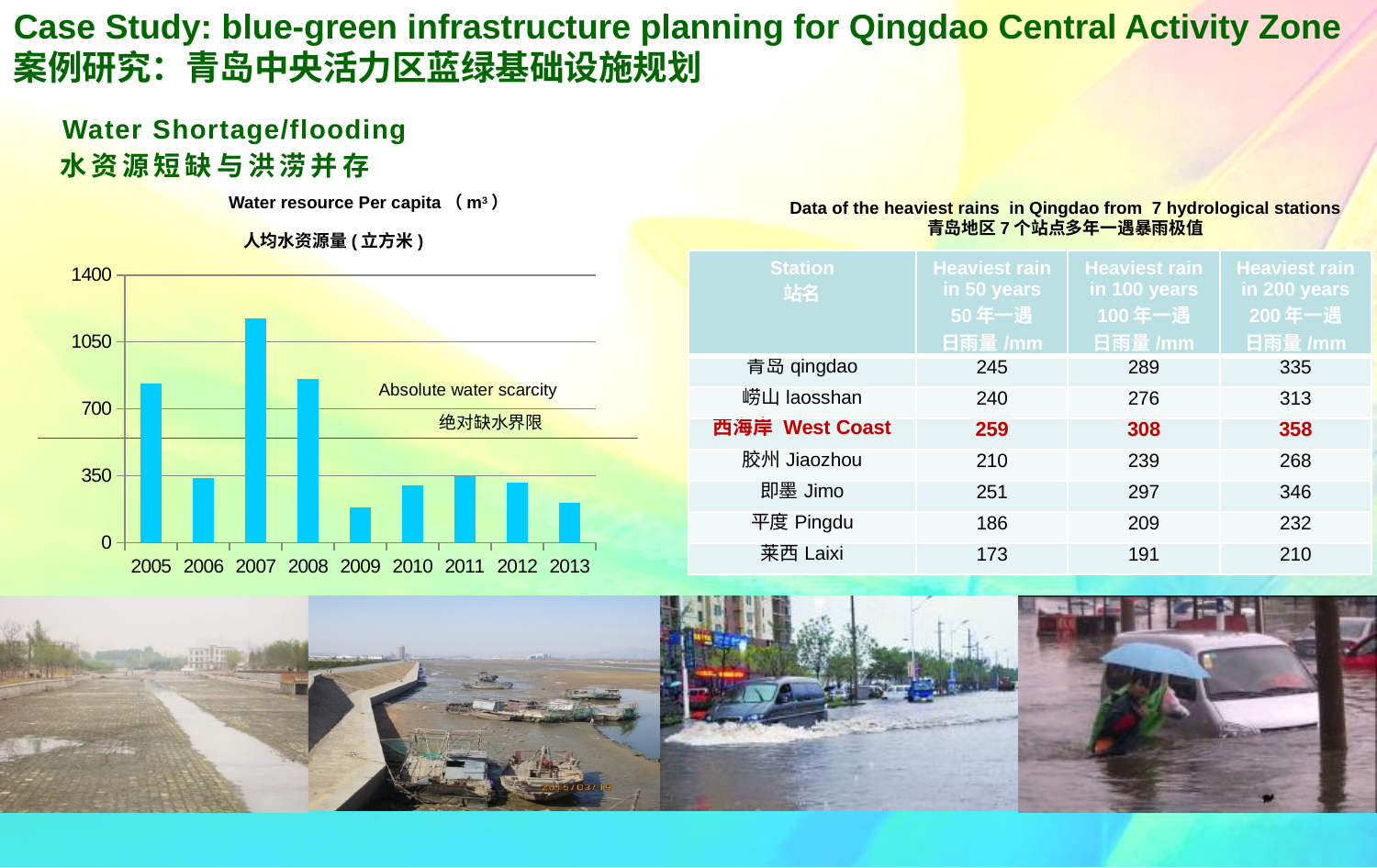
In the "Water resource Per capita" chart, is the value for 2005 greater or less than 700? greater What unit is given in the title of the "Water resource Per capita" chart? m³ In the "Water resource Per capita" chart, is the value for 2007 greater or less than 1050? greater In the "Water resource Per capita" chart, is the value for 2009 greater or less than 350? less What kind of chart is the "Water resource Per capita" chart? bar chart What is the label of the horizontal reference line drawn across the "Water resource Per capita" chart? Absolute water scarcity In the "Water resource Per capita" chart, which year has the lowest value? 2009 How many years are shown on the x axis of the "Water resource Per capita" chart? 9 In the "Water resource Per capita" chart, which is larger, the value for 2007 or the value for 2005? 2007 In the "Water resource Per capita" chart, which is larger, the value for 2005 or the value for 2006? 2005 In the "Water resource Per capita" chart, which year has the highest value? 2007